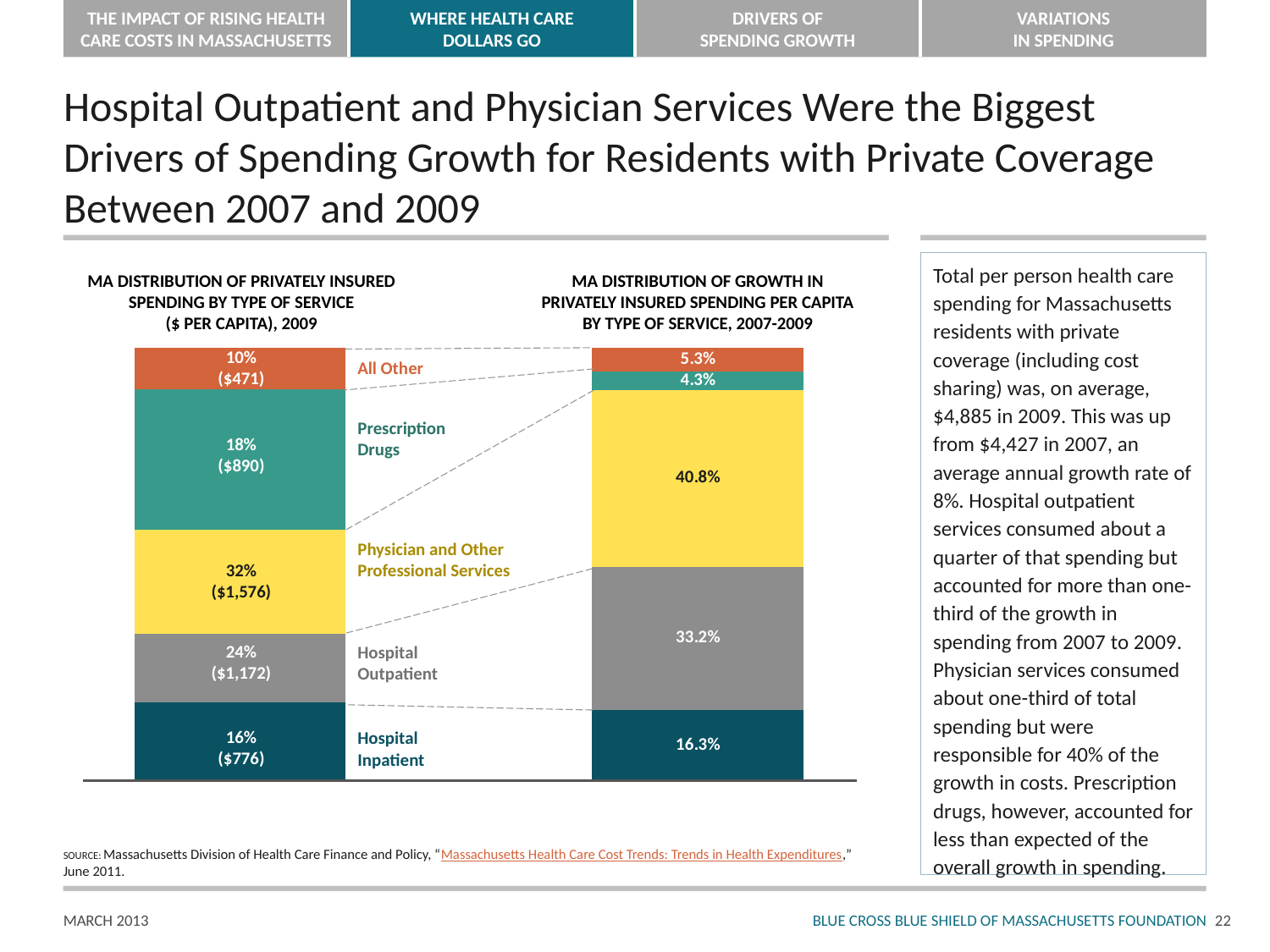
How many types of service are shown in each stacked bar on the slide? 5 In the right chart (distribution of growth in spending, 2007-2009), which type of service accounts for the largest share of growth? Physician and Other Professional Services In the left chart (spending by type of service, 2009), how much larger is per capita spending on Physician and Other Professional Services than on Hospital Inpatient? $800 In the left chart (spending by type of service, 2009), which type of service has the smallest per capita spending? All Other In the right chart (distribution of growth in spending, 2007-2009), what share of growth is attributed to Hospital Outpatient? 33.2% In the left chart (spending by type of service, 2009), what is the per capita dollar amount for Prescription Drugs? $890 In the right chart (distribution of growth in spending, 2007-2009), which is larger: the share for Hospital Inpatient or the share for All Other? Hospital Inpatient In the right chart (distribution of growth in spending, 2007-2009), what share of growth is attributed to Prescription Drugs? 4.3% In the left chart (spending by type of service, 2009), what is the per capita dollar amount for Hospital Outpatient? $1,172 What kind of chart is used on this slide? Stacked bar chart In the right chart (distribution of growth in spending, 2007-2009), which type of service accounts for the smallest share of growth? Prescription Drugs In the left chart (MA distribution of privately insured spending by type of service, 2009), what share of spending went to Physician and Other Professional Services? 32%